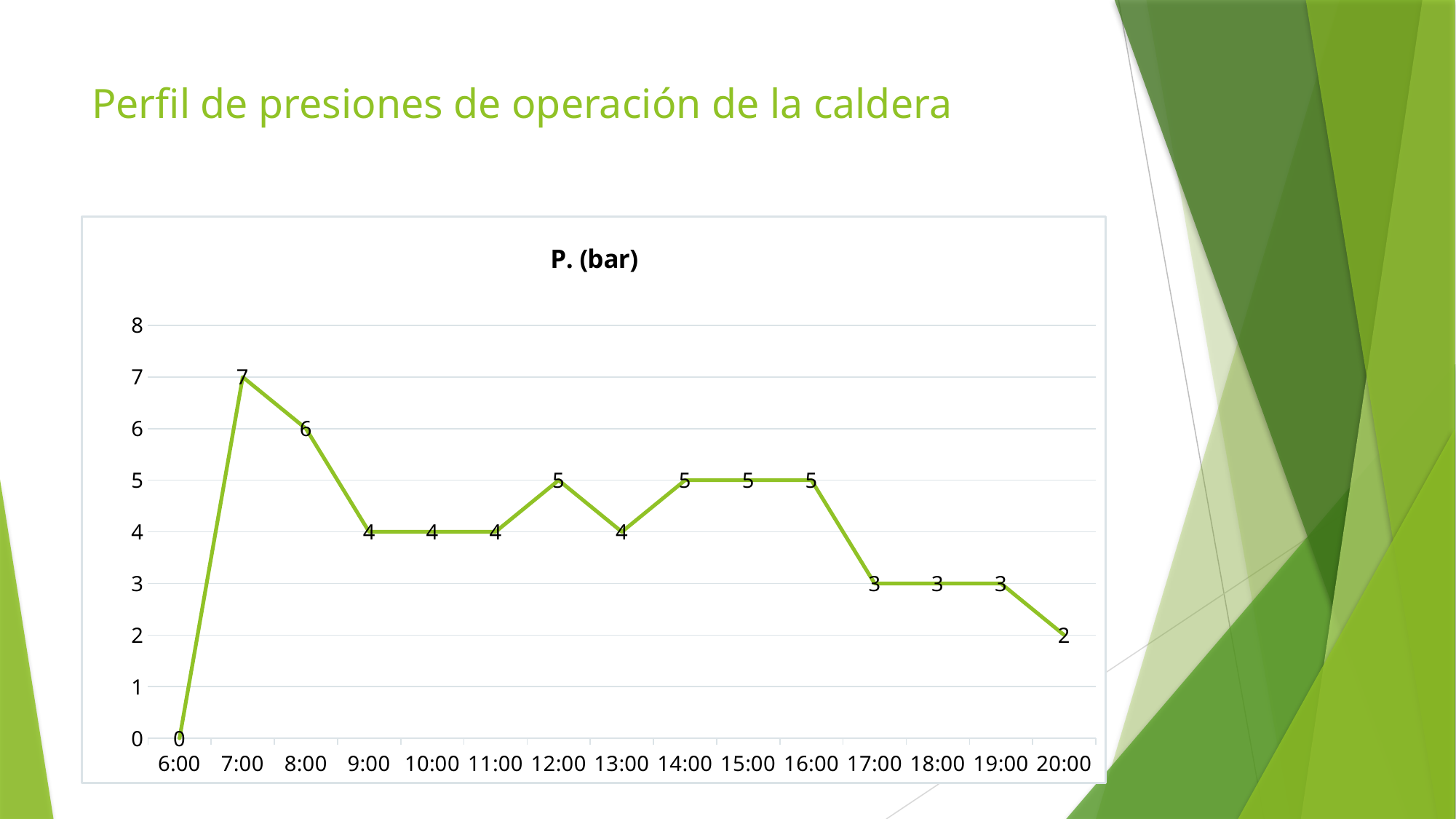
What is the value at 13:00? 4 What kind of chart is shown? line chart Do the values rise or fall from 16:00 to 20:00? fall Which is larger, the value at 12:00 or the value at 18:00? 12:00 What is the difference between the values at 7:00 and 8:00? 1 At which time is the value highest? 7:00 What is the difference between the values at 16:00 and 17:00? 2 How many time points are plotted on the chart? 15 What is the value at 20:00? 2 At which time is the value lowest? 6:00 What is the value at 7:00? 7 What is the title of the chart? P. (bar)